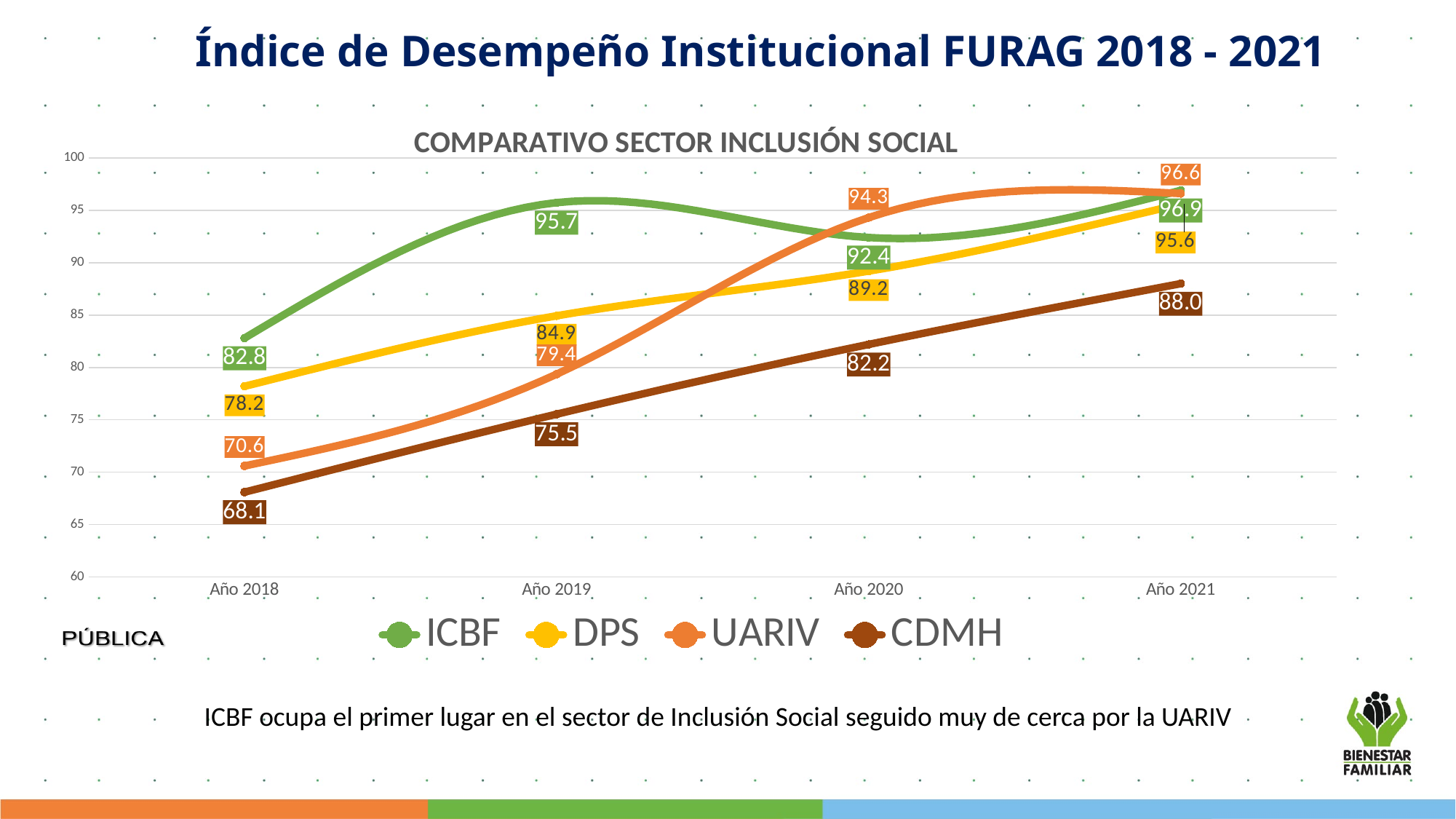
What is the value for CDMH in Año 2018? 68.1 Which is larger in Año 2020, the value for ICBF or the value for DPS? ICBF How many series does the legend list? 4 What kind of chart is shown on the slide? Line chart What is the value for UARIV in Año 2020? 94.3 What is the difference between the CDMH values in Año 2021 and Año 2018? 19.9 Which series has the lowest value in Año 2018? CDMH How many years are shown on the x axis? 4 Which series has the highest value in Año 2019? ICBF What is the value for ICBF in Año 2019? 95.7 Do the values for DPS rise or fall from Año 2018 to Año 2021? Rise What is the value for DPS in Año 2021? 95.6